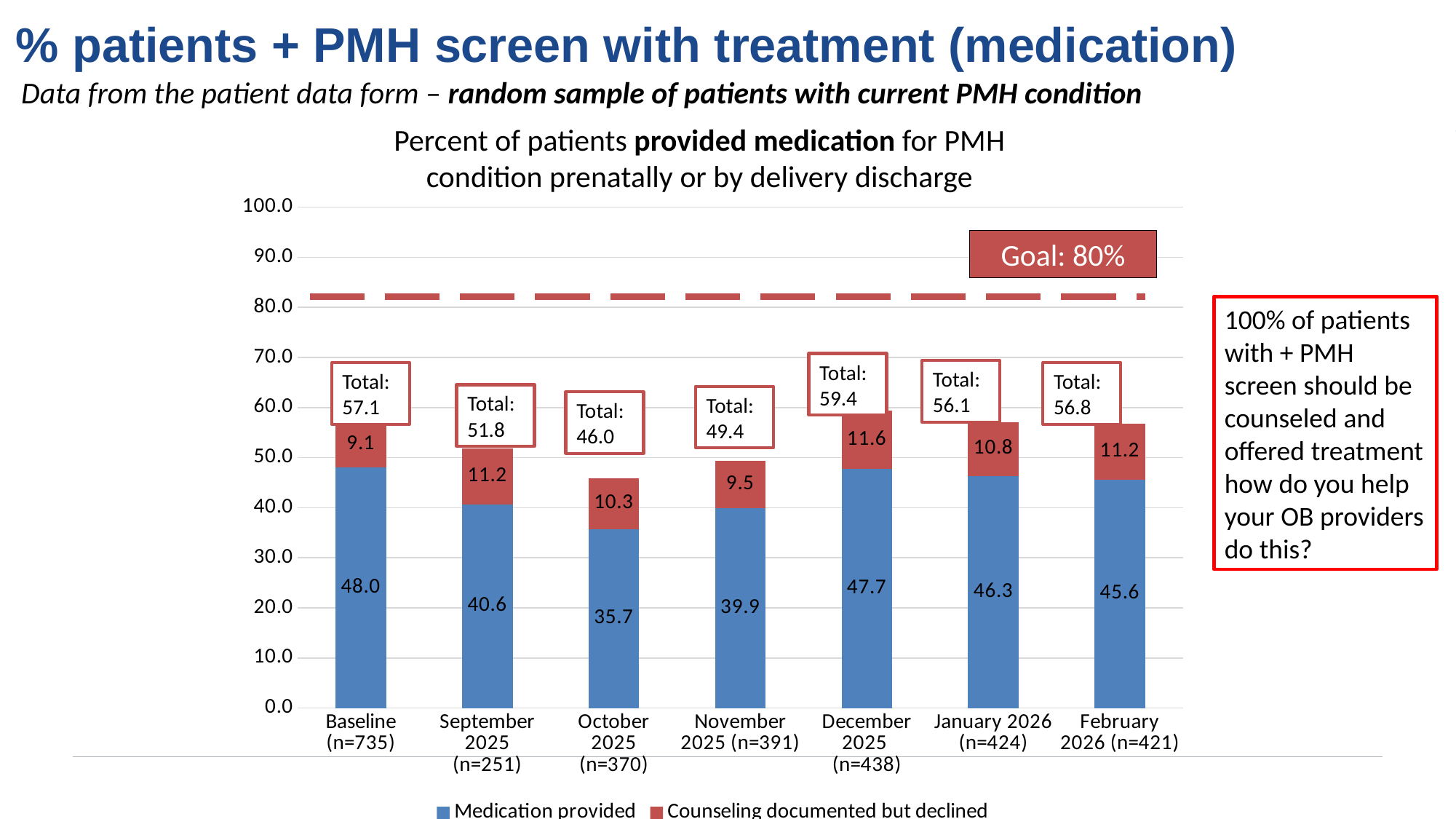
Which category has the highest Medication provided value? Baseline (n=735) Which category has the lowest Medication provided value? October 2025 (n=370) How many series does the legend list? 2 Which category has the highest stacked total? December 2025 (n=438) What is the value for Medication provided at Baseline (n=735)? 48.0 Is the stacked total for December 2025 greater or less than 80? less Which is larger, the Medication provided value for January 2026 or for February 2026? January 2026 What kind of chart is shown? Stacked bar chart What is the difference between the Medication provided values for Baseline and October 2025? 12.3 What is the stacked total for November 2025 (n=391)? 49.4 How many categories are shown on the x axis? 7 What is the value for Counseling documented but declined in December 2025 (n=438)? 11.6